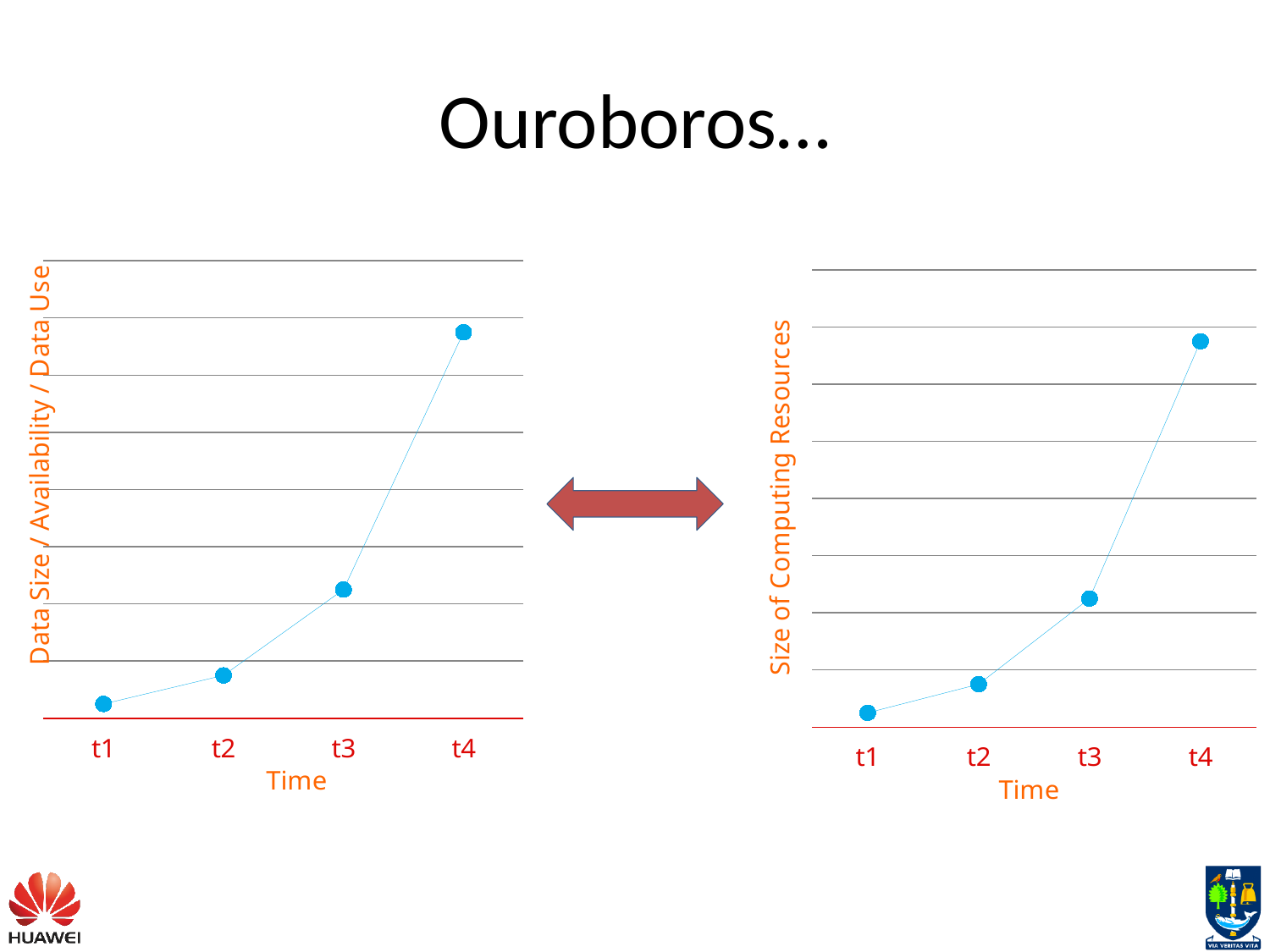
On the left chart, do the values rise or fall from t1 to t4? rise On the right chart, do the values rise or fall along the Time axis? rise What is the y-axis title of the right chart? Size of Computing Resources On the left chart, which time point has the highest value? t4 On the right chart, which is larger, the value at t3 or the value at t4? t4 On the right chart, how many categories are on the x axis? 4 On the right chart, which time point has the lowest value? t1 What is the y-axis title of the left chart? Data Size / Availability / Data Use On the left chart, what kind of chart is shown? line chart On the left chart, how many data points are plotted? 4 On the left chart, which is larger, the value at t2 or the value at t3? t3 On the right chart, what kind of chart is shown? line chart